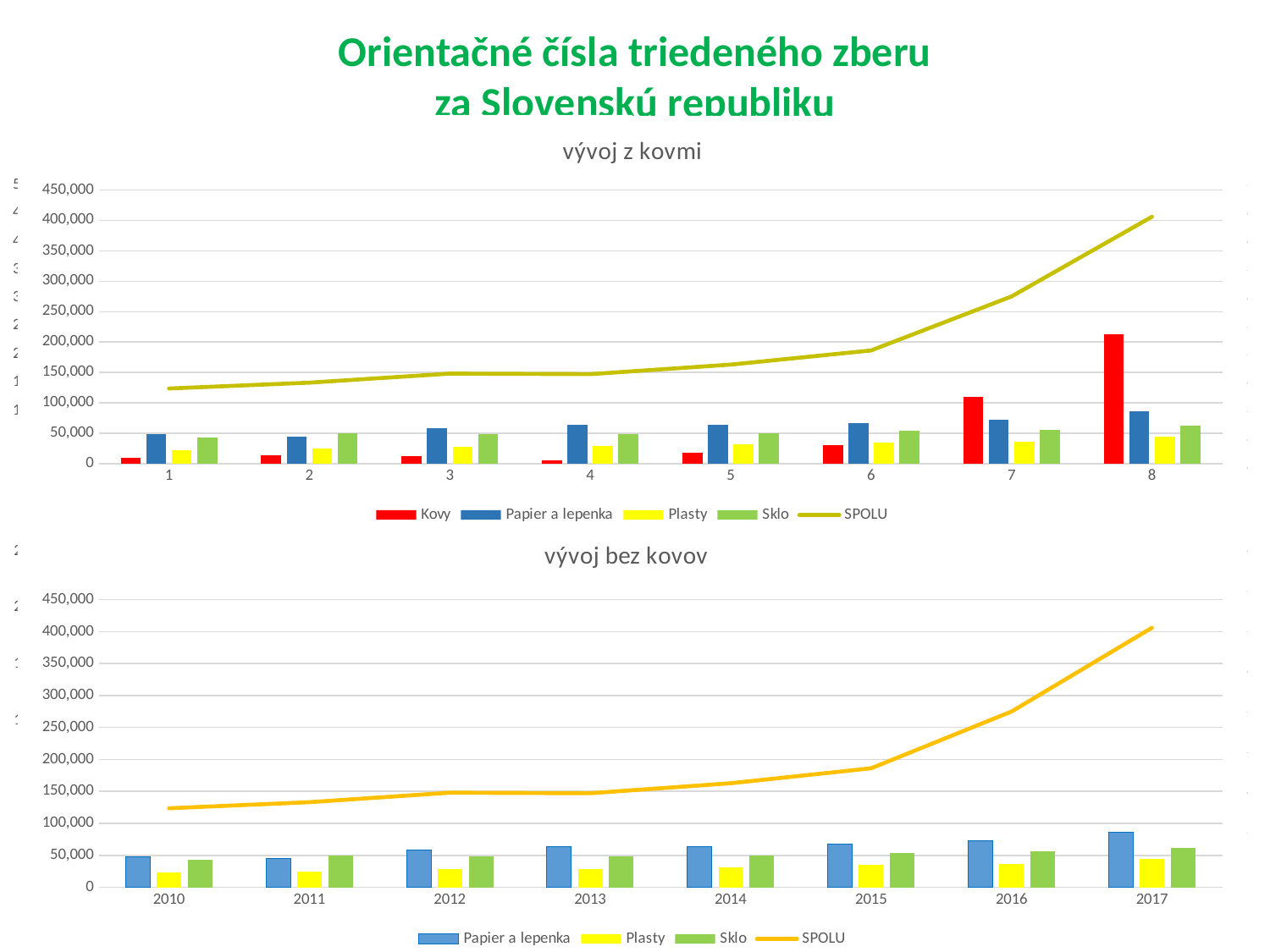
In the chart titled "vývoj z kovmi", how many series does the legend list? 5 In the chart titled "vývoj bez kovov", does the SPOLU line rise or fall from 2010 to 2017? rise In the chart titled "vývoj bez kovov", in which year is the Papier a lepenka bar highest? 2017 In the chart titled "vývoj z kovmi", what kind of chart is it? A combined bar and line chart In the chart titled "vývoj bez kovov", how many years are shown on the x axis? 8 In the chart titled "vývoj z kovmi", at which category is the Kovy bar highest? 8 In the chart titled "vývoj bez kovov", how many series does the legend list? 4 In the chart titled "vývoj z kovmi", at which category is the Kovy bar lowest? 4 In the chart titled "vývoj bez kovov", which series is drawn as a line rather than bars? SPOLU In the chart titled "vývoj z kovmi", is the Kovy value at category 8 greater or less than 150,000? greater In the chart titled "vývoj bez kovov", is the SPOLU value for 2015 greater or less than 200,000? less In the chart titled "vývoj z kovmi", is the SPOLU value at category 1 greater or less than 150,000? less